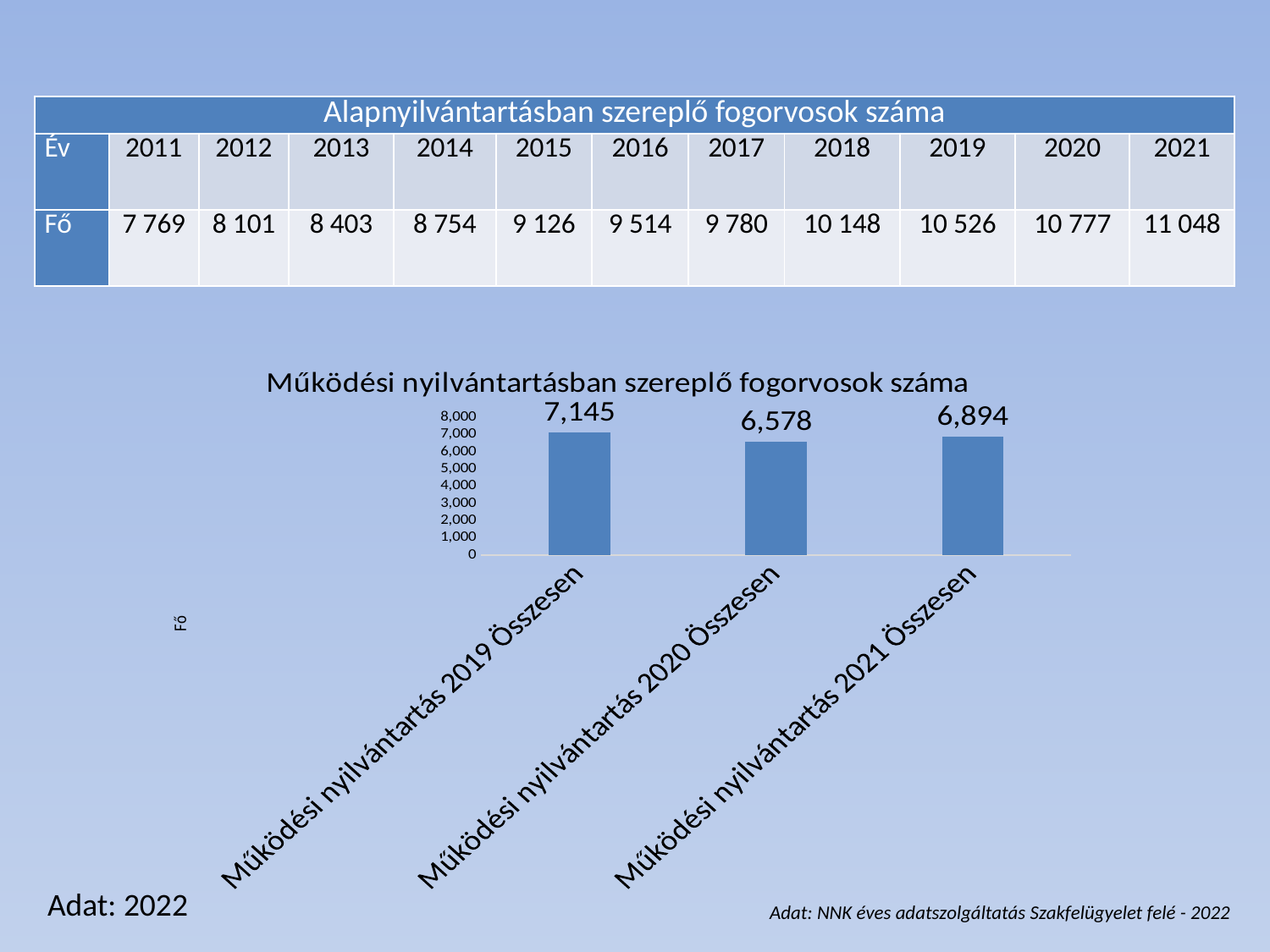
Which category has the highest value in the chart? Működési nyilvántartás 2019 Összesen What is the value for Működési nyilvántartás 2020 Összesen? 6,578 What is the difference between the 2019 Összesen and 2020 Összesen values? 567 What type of chart is shown on the slide? bar chart What is the difference between the 2021 Összesen and 2020 Összesen values? 316 Which is larger, the value for 2021 Összesen or 2020 Összesen? 2021 Összesen What is the title of the chart? Működési nyilvántartásban szereplő fogorvosok száma How many bars are plotted in the chart? 3 Which category has the lowest value in the chart? Működési nyilvántartás 2020 Összesen What is the value for Működési nyilvántartás 2021 Összesen? 6,894 What is the label on the vertical axis of the chart? Fő What is the value for Működési nyilvántartás 2019 Összesen? 7,145